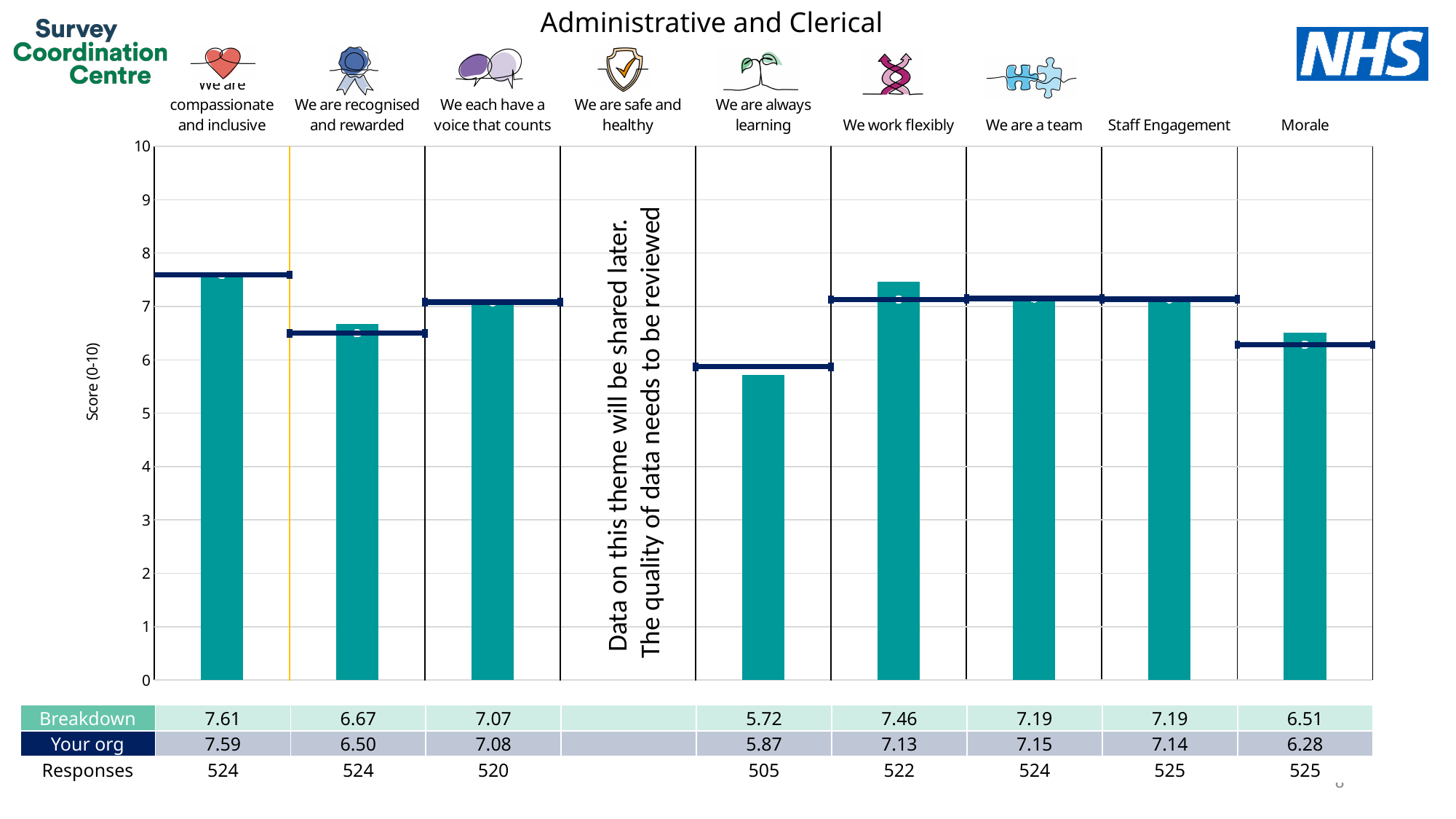
How many responses are recorded for 'We are always learning'? 505 Which theme has the highest Breakdown score? We are compassionate and inclusive What kind of chart is shown on the slide? bar chart Which is larger for 'We are always learning': the Breakdown score or the Your org score? Your org Is the Breakdown bar for 'We are recognised and rewarded' greater or less than 7? less Which theme has the lowest Breakdown score? We are always learning What is the difference between the Breakdown and Your org scores for 'Morale'? 0.23 What is the Your org score for 'Morale'? 6.28 Which theme has no data plotted on the chart? We are safe and healthy What is the title of the chart? Administrative and Clerical What is the Breakdown score for 'We work flexibly'? 7.46 How many teal bars are plotted on the chart? 8